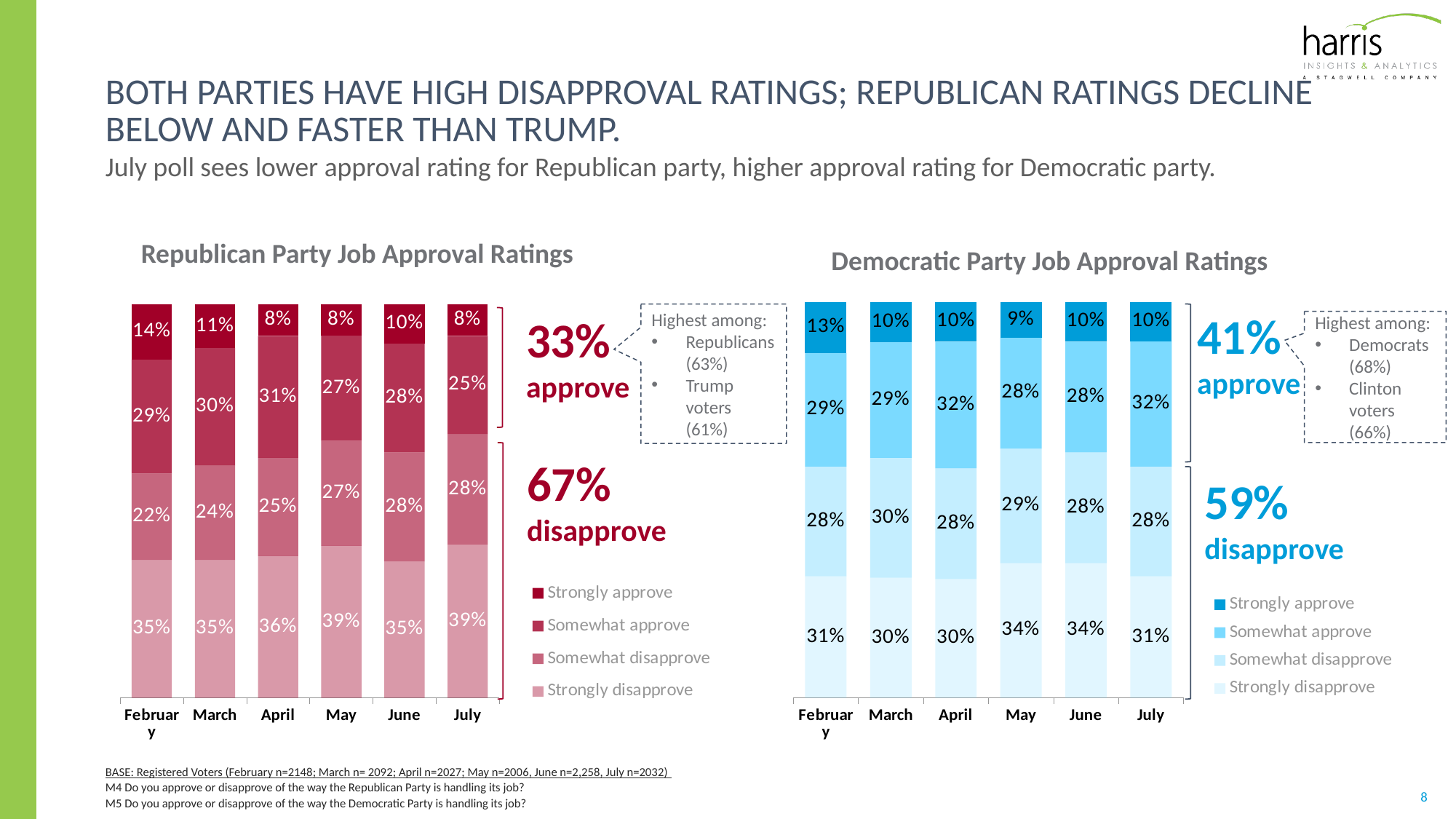
In the Democratic Party Job Approval Ratings chart, what is the Somewhat approve value for July? 32% How many series does the legend of the Democratic Party Job Approval Ratings chart list? 4 In the Democratic Party Job Approval Ratings chart, is the Strongly disapprove value larger in May or in March? May In the Republican Party Job Approval Ratings chart, what is the Strongly approve value for February? 14% In the Republican Party Job Approval Ratings chart, does the Strongly approve value rise or fall from February to April? Fall What kind of chart is the Democratic Party Job Approval Ratings chart? Stacked bar chart How many months are shown on the x axis of the Republican Party Job Approval Ratings chart? 6 In the Republican Party Job Approval Ratings chart, which month has the highest Strongly approve value? February In the Republican Party Job Approval Ratings chart, what is the difference between the Somewhat disapprove values for July and February? 6% In the Republican Party Job Approval Ratings chart, what is the Strongly disapprove value for May? 39% In the Democratic Party Job Approval Ratings chart, what is the total of the Strongly approve and Somewhat approve segments for July? 42% In the Democratic Party Job Approval Ratings chart, which month has the lowest Strongly approve value? May